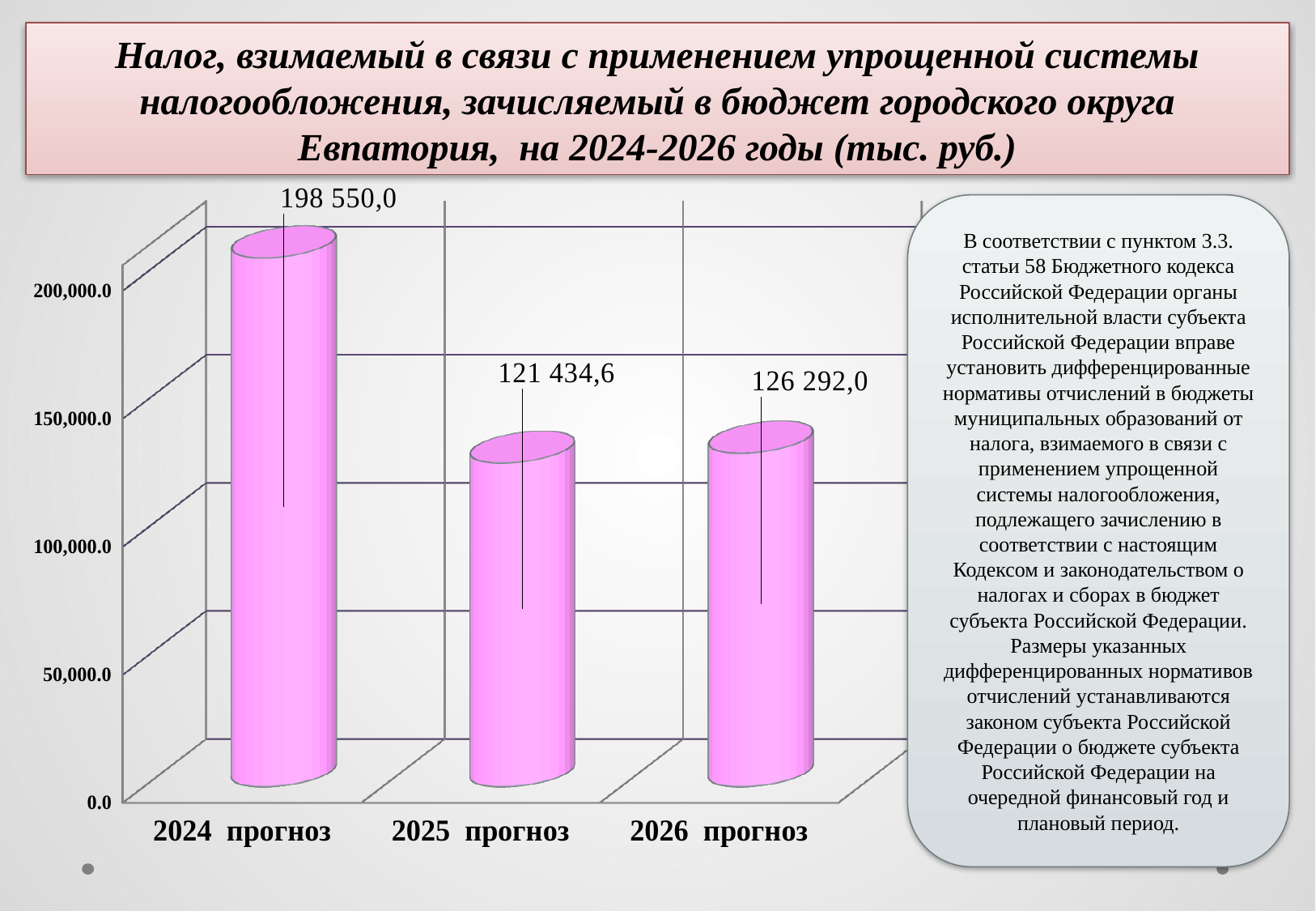
Is the value for 2025 прогноз greater or less than 150,000.0? less Which year has the lowest value? 2025 прогноз What is the difference between the values for 2024 прогноз and 2025 прогноз? 77 115,4 What is the value for 2024 прогноз? 198 550,0 How many categories are shown on the chart? 3 Does the value rise or fall from 2024 прогноз to 2025 прогноз? fall What is the value for 2025 прогноз? 121 434,6 What kind of chart is shown on the slide? bar chart Which year has the highest value? 2024 прогноз Which is larger, the value for 2025 прогноз or 2026 прогноз? 2026 прогноз What is the value for 2026 прогноз? 126 292,0 What is the difference between the values for 2026 прогноз and 2025 прогноз? 4 857,4